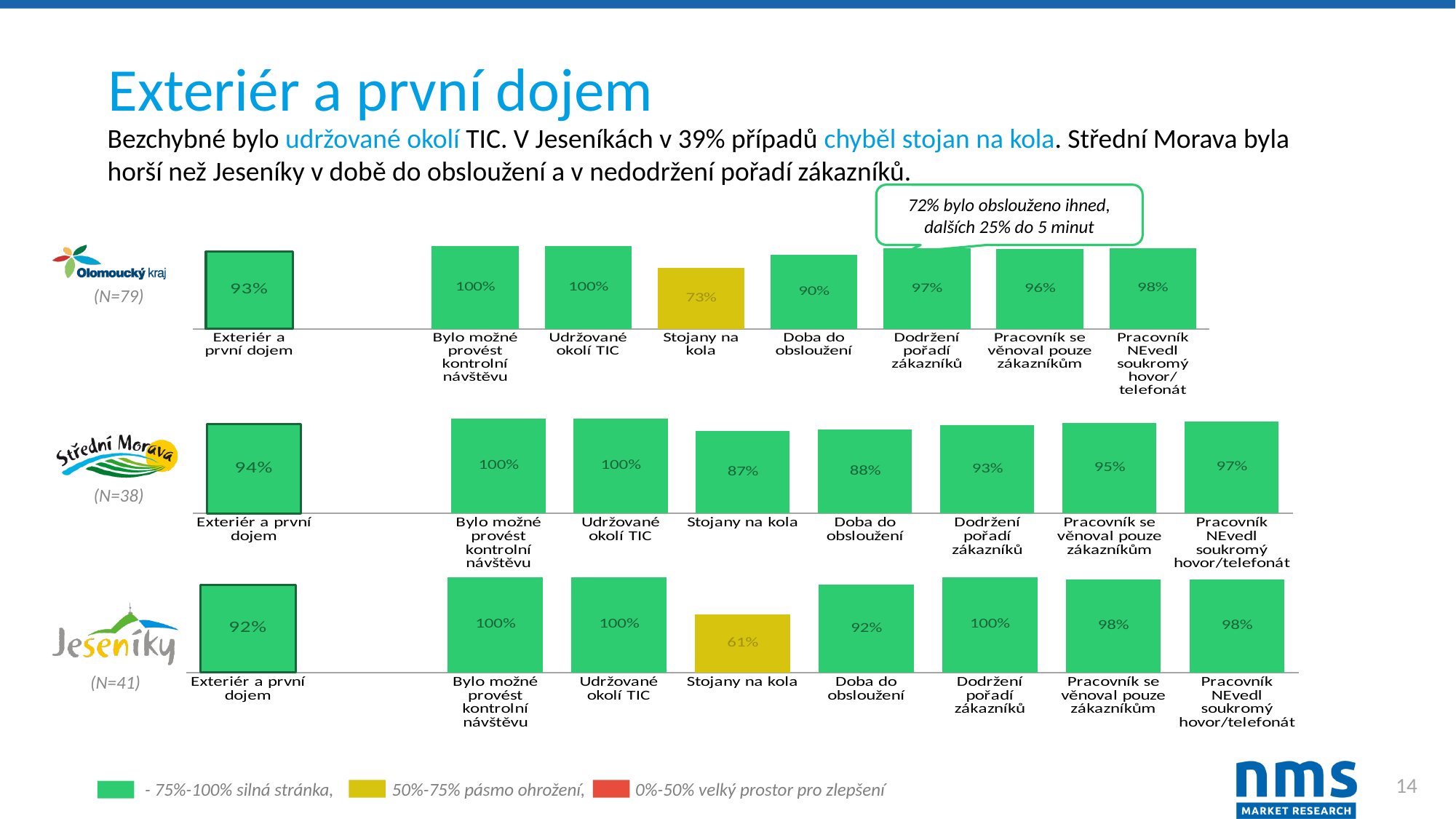
What kind of chart is the Střední Morava chart? Bar chart In the Střední Morava chart, which category has the lowest value? Stojany na kola In the Olomoucký kraj chart, what is the value for Stojany na kola? 73% In the Jeseníky chart, what is the value for Stojany na kola? 61% In the Jeseníky chart, what is the difference between Pracovník se věnoval pouze zákazníkům and Stojany na kola? 37 percentage points Which is larger: Doba do obsloužení in the Střední Morava chart or Doba do obsloužení in the Jeseníky chart? Jeseníky In the Olomoucký kraj chart, what is the difference between Dodržení pořadí zákazníků and Doba do obsloužení? 7 percentage points In the Olomoucký kraj chart, which category has the lowest value? Stojany na kola What is the sample size (N) shown for the Olomoucký kraj chart? N=79 In the Jeseníky chart, what is the value for Dodržení pořadí zákazníků? 100% In the Střední Morava chart, what is the value for Doba do obsloužení? 88% How many categories does the Jeseníky chart show? 8